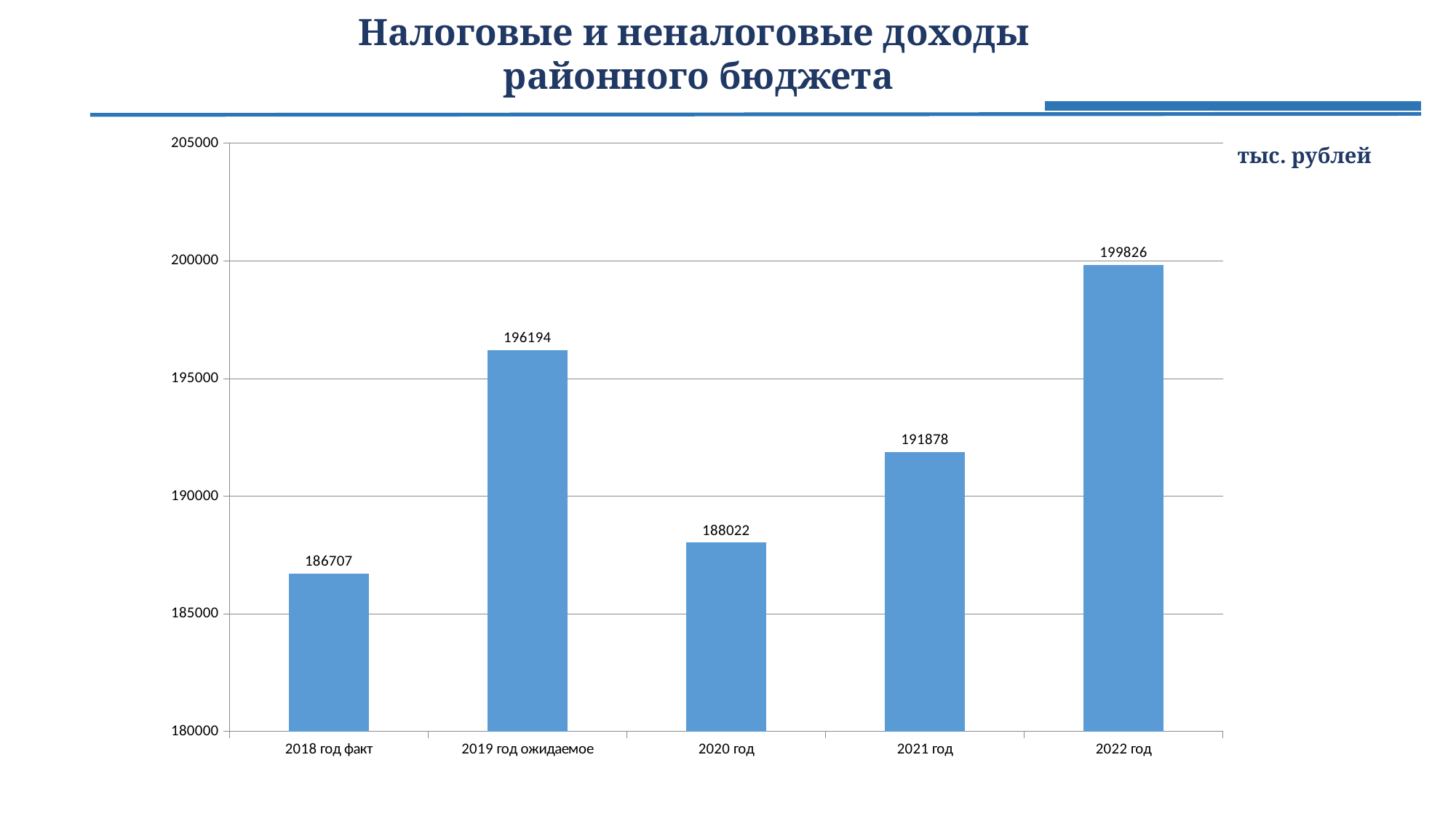
Which is larger, the value for 2019 год ожидаемое or the value for 2020 год? 2019 год ожидаемое What is the difference between the values for 2022 год and 2021 год? 7948 What kind of chart is shown on the slide? bar chart What unit is indicated next to the chart? тыс. рублей What is the value for 2022 год? 199826 What is the value for 2018 год факт? 186707 Is the value for 2021 год greater or less than 190000? greater How many categories are shown on the x axis? 5 What is the value for 2020 год? 188022 Which category has the lowest value? 2018 год факт Which category has the highest value? 2022 год What is the value for 2019 год ожидаемое? 196194